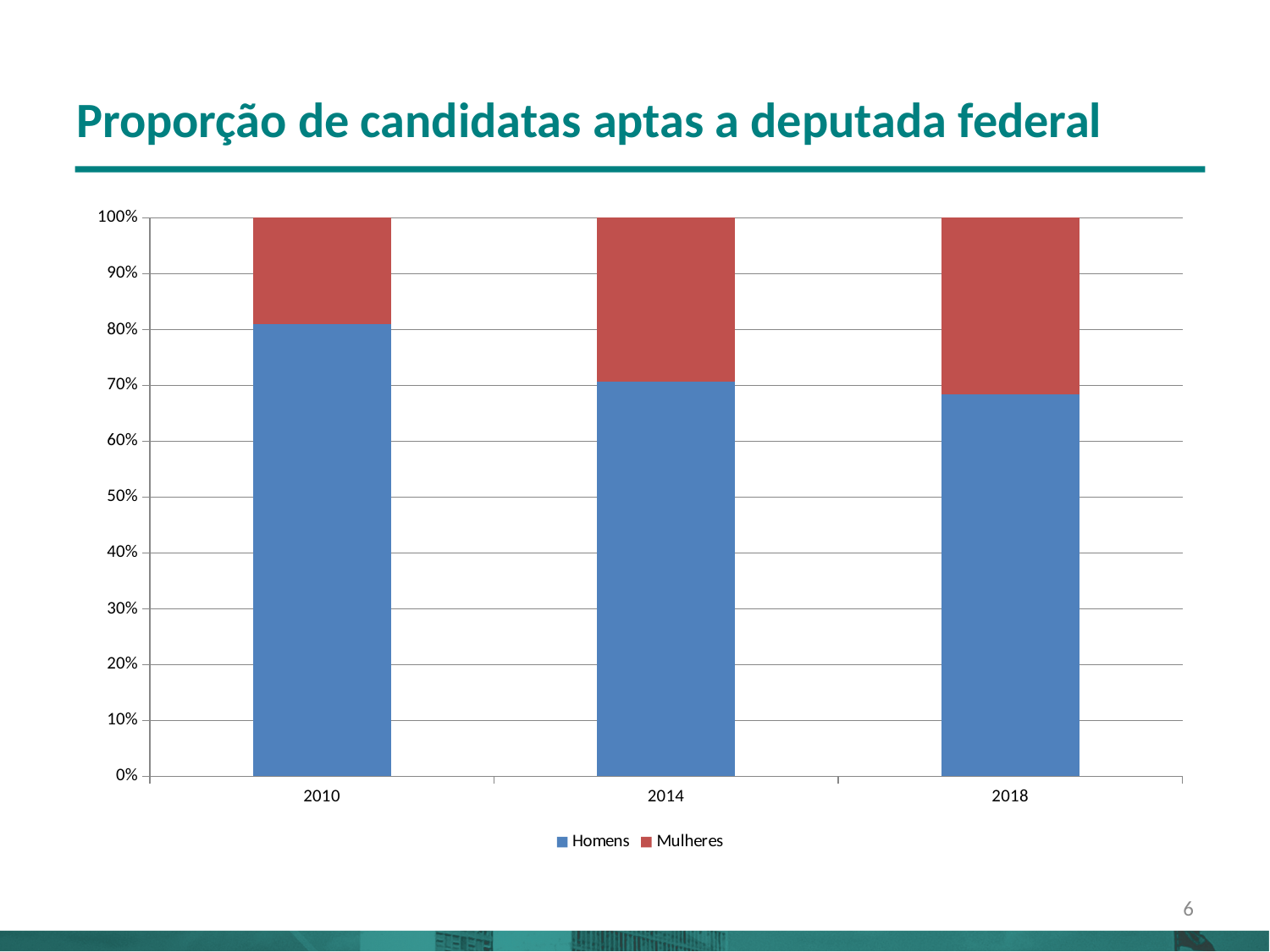
In which year is the Mulheres share highest? 2018 Does the Homens share rise or fall from 2010 to 2018? fall Is the Mulheres share in 2010 greater or less than 30%? less What kind of chart is shown on the slide? stacked bar chart How many series does the legend list? 2 In which year is the Homens share highest? 2010 Which series is shown in blue? Homens Is the Homens share in 2014 greater or less than 80%? less How many years are shown on the x axis? 3 What is the title of the slide? Proporção de candidatas aptas a deputada federal Which is larger, the Homens share in 2010 or in 2014? 2010 In which year is the Homens share lowest? 2018